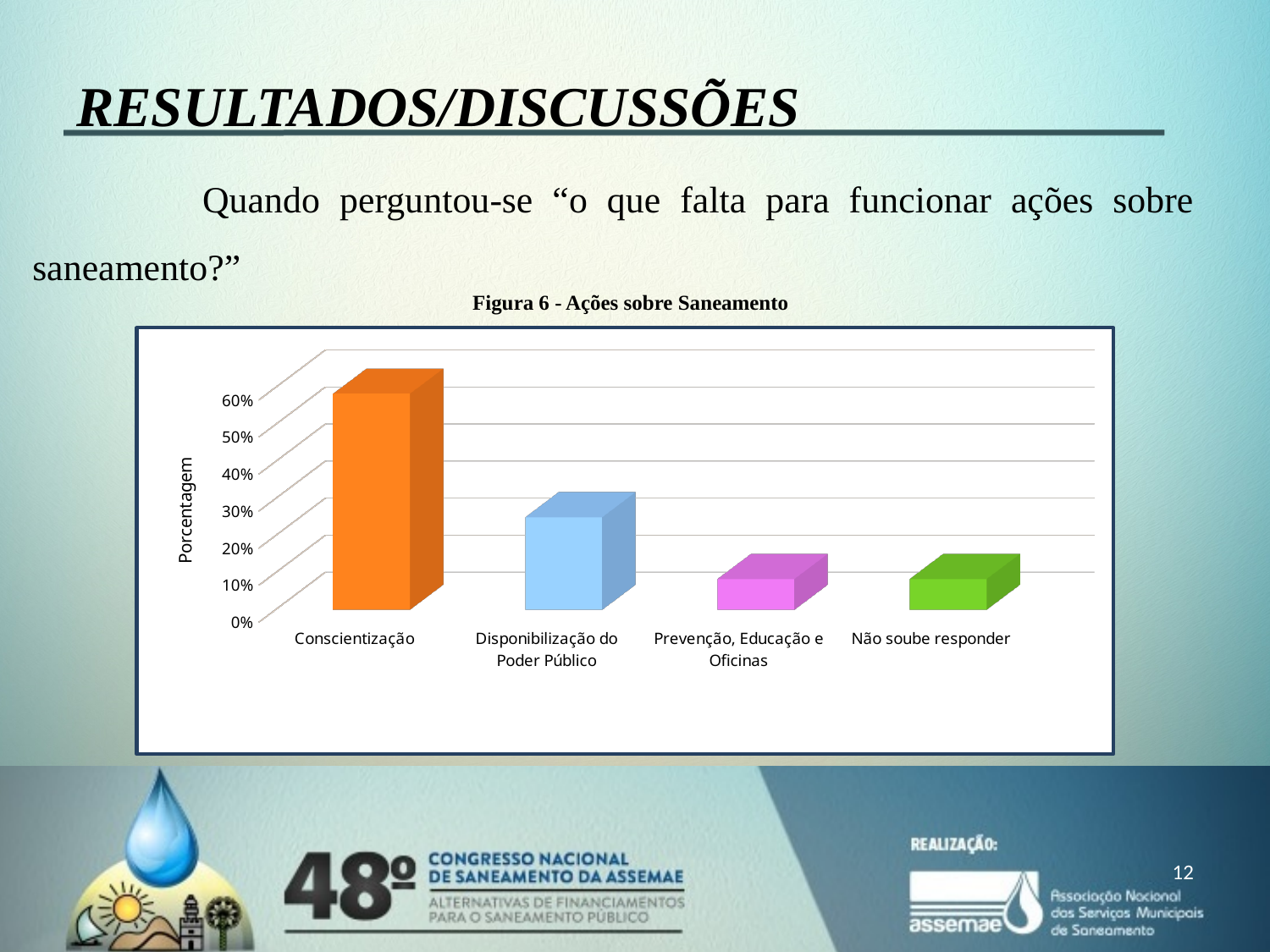
What is the title of the chart? Figura 6 - Ações sobre Saneamento Is the value for Disponibilização do Poder Público greater or less than 40%? less Which category has the highest value in the chart? Conscientização Which is larger, the value for Conscientização or the value for Disponibilização do Poder Público? Conscientização Is the value for Prevenção, Educação e Oficinas greater or less than 20%? less What is the label on the vertical axis of the chart? Porcentagem How many categories are shown on the x axis of the chart? 4 What kind of chart is shown in Figura 6? bar chart Is the value for Não soube responder greater or less than 20%? less Which is larger, the value for Disponibilização do Poder Público or the value for Prevenção, Educação e Oficinas? Disponibilização do Poder Público Do the bar values rise or fall from left to right across the x axis? fall